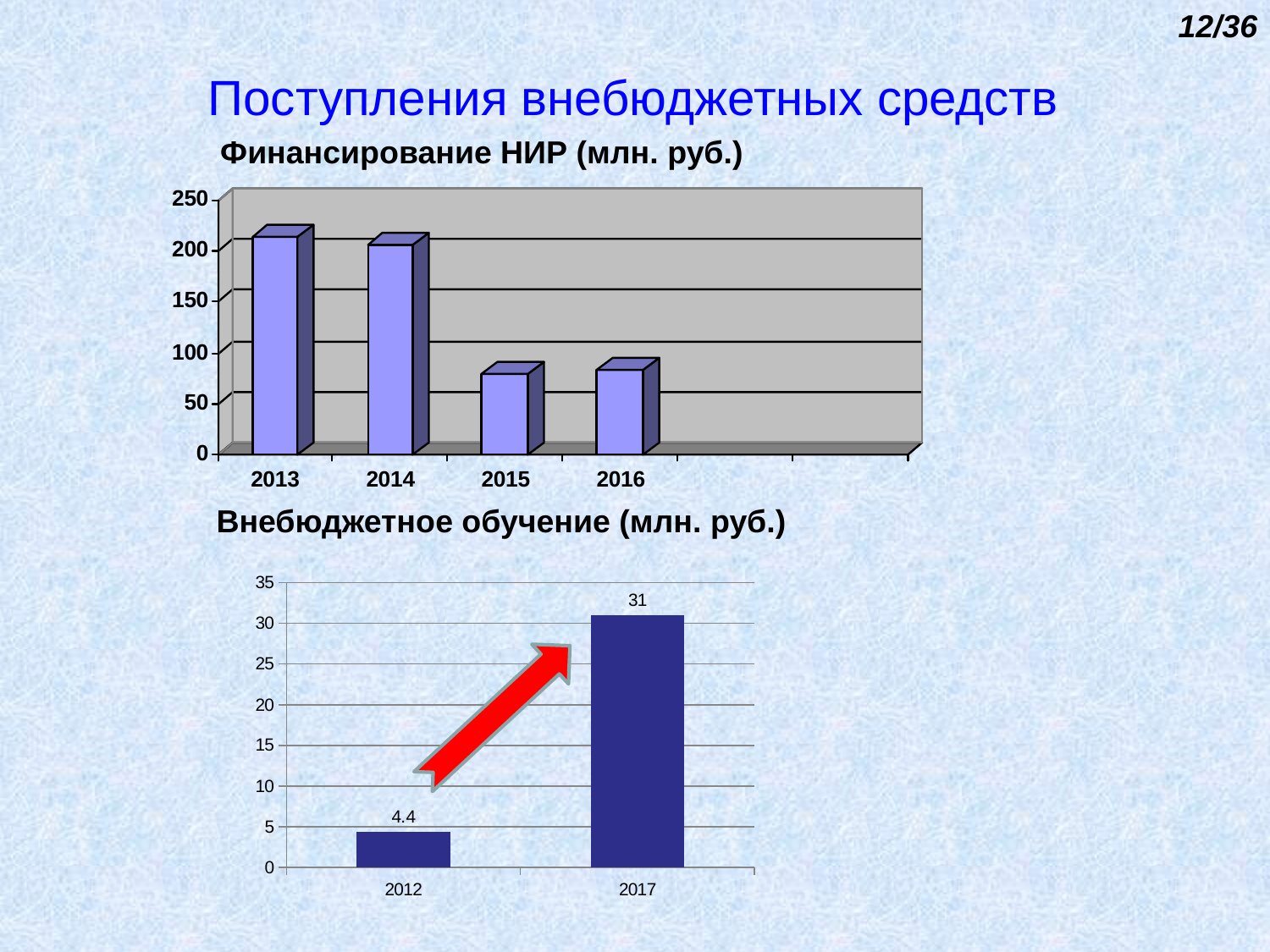
In the bottom chart (Внебюджетное обучение), what is the difference between the 2017 and 2012 values? 26.6 In the bottom chart (Внебюджетное обучение), which year has the higher value? 2017 In the top chart (Финансирование НИР), is the value for 2015 greater or less than 100? less In the top chart (Финансирование НИР), is the value for 2014 greater or less than 150? greater What kind of chart is the bottom chart (Внебюджетное обучение)? bar chart In the bottom chart (Внебюджетное обучение), what is the value for 2017? 31 In the top chart (Финансирование НИР), is the value for 2013 larger or smaller than the value for 2016? larger In the top chart (Финансирование НИР), is the value for 2013 greater or less than 200? greater In the bottom chart (Внебюджетное обучение), what is the value for 2012? 4.4 What is the title of the top chart on the slide? Финансирование НИР (млн. руб.) In the top chart (Финансирование НИР), do the values generally rise or fall from 2013 to 2016? fall In the top chart (Финансирование НИР), how many years are shown on the x axis? 4